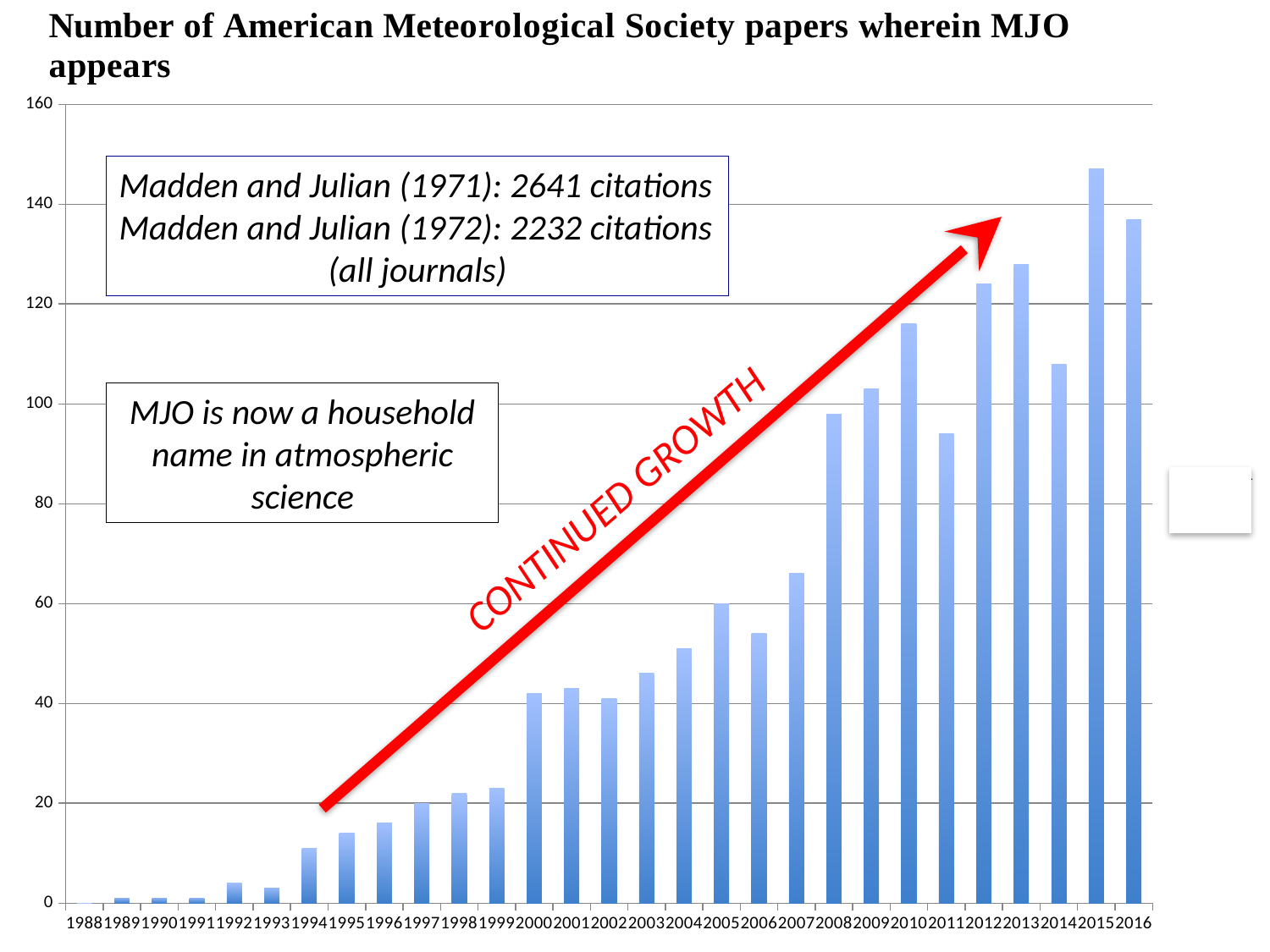
Which year has the larger value, 2010 or 2011? 2010 Which year has the larger value, 2013 or 2014? 2013 What kind of chart is shown on the slide? Bar chart Is the value for 2015 greater or less than 140? greater Is the value for 2013 greater or less than 120? greater Is the value for 2011 greater or less than 100? less How many years are shown along the x axis of the chart? 29 Overall, do the values rise or fall from 1988 to 2016? Rise What is the title of the chart? Number of American Meteorological Society papers wherein MJO appears Which year has the highest number of AMS papers wherein MJO appears? 2015